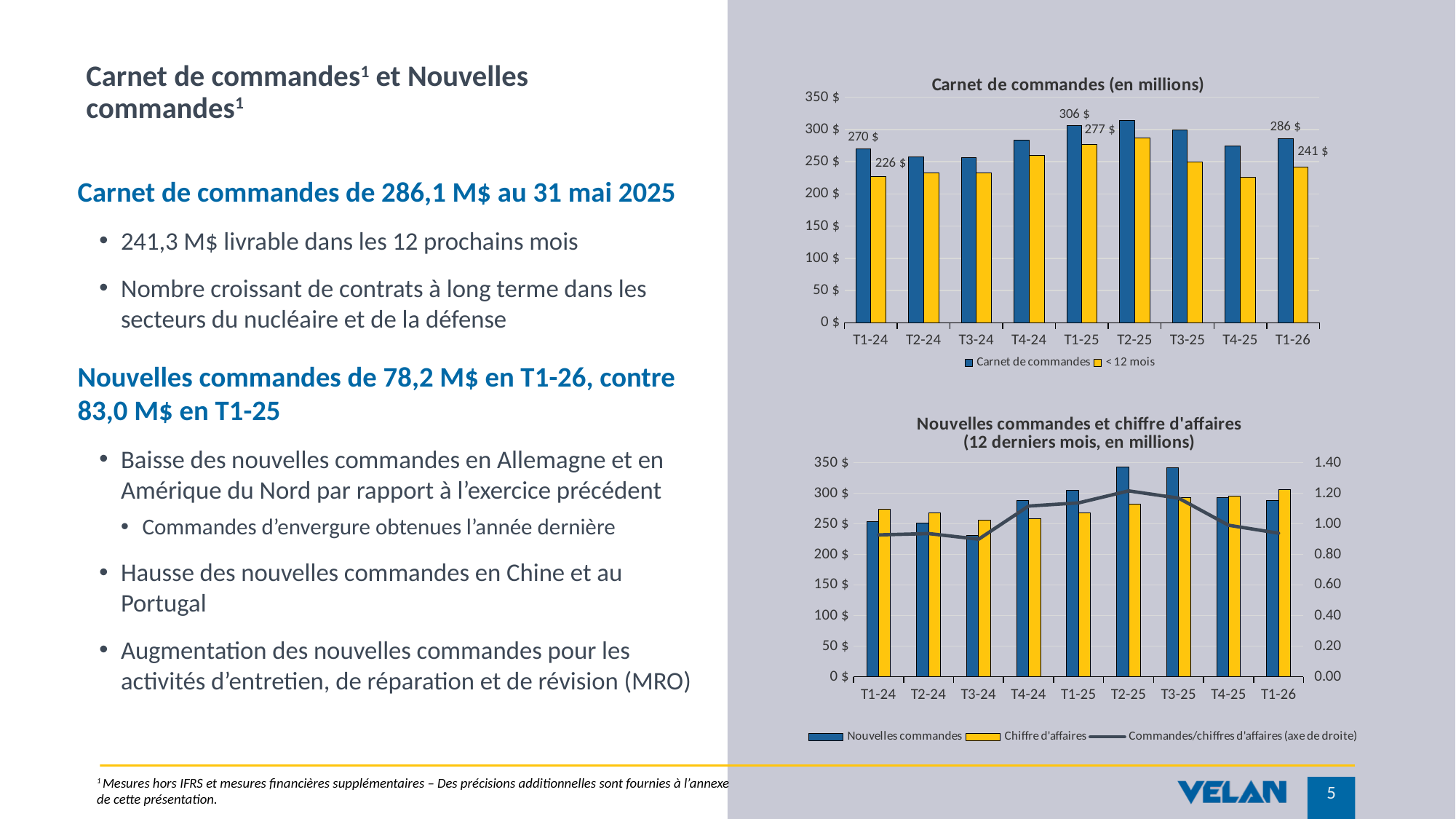
In the 'Nouvelles commandes et chiffre d'affaires' chart, does the Commandes/chiffres d'affaires line rise or fall from T2-25 to T1-26? Fall In the 'Nouvelles commandes et chiffre d'affaires' chart, is the Nouvelles commandes value for T2-25 greater or less than 300 $? greater How many series does the legend of the 'Nouvelles commandes et chiffre d'affaires' chart list? 3 In the 'Carnet de commandes (en millions)' chart, by how much did the Carnet de commandes value change from T1-25 to T1-26? 20 $ In the 'Carnet de commandes (en millions)' chart, which is larger: the Carnet de commandes value for T1-24 or for T1-25? T1-25 In the 'Carnet de commandes (en millions)' chart, what is the difference between the Carnet de commandes and the '< 12 mois' values for T1-25? 29 $ In the 'Carnet de commandes (en millions)' chart, what is the value of Carnet de commandes for T1-24? 270 $ How many quarters are shown on the x axis of the 'Carnet de commandes (en millions)' chart? 9 What kind of chart is the 'Carnet de commandes (en millions)' chart? Bar chart In the 'Carnet de commandes (en millions)' chart, what is the '< 12 mois' value for T1-25? 277 $ In the 'Carnet de commandes (en millions)' chart, what is the Carnet de commandes value for T1-26? 286 $ In the 'Nouvelles commandes et chiffre d'affaires' chart, is the Nouvelles commandes value for T3-24 greater or less than 250 $? less